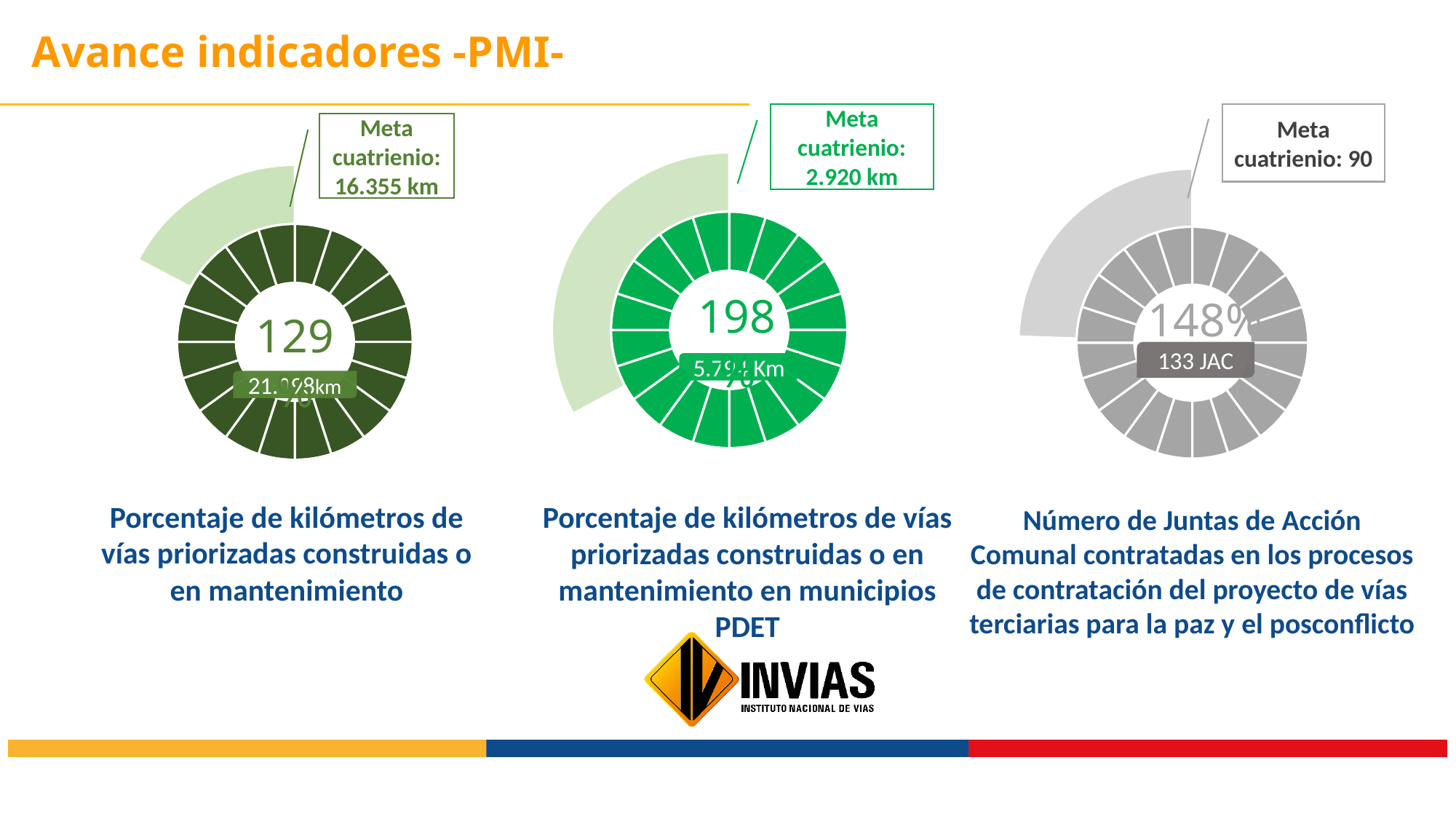
On the right-hand chart, by how much does the reported 133 JAC exceed the Meta cuatrienio of 90? 43 How many ring charts are shown on the slide? 3 On the chart titled 'Número de Juntas de Acción Comunal contratadas...', how many JAC are reported in the label below the percentage? 133 JAC On the chart titled 'Porcentaje de kilómetros de vías priorizadas construidas o en mantenimiento', what value is shown in the centre of the ring? 129 What is the 'Meta cuatrienio' shown for the right-hand chart? 90 What is the 'Meta cuatrienio' shown for the left-hand chart? 16.355 km On the chart titled 'Porcentaje de kilómetros de vías priorizadas construidas o en mantenimiento en municipios PDET', what value is shown in the centre of the ring? 198 Which of the three charts shows the highest central value? Porcentaje de kilómetros de vías priorizadas construidas o en mantenimiento en municipios PDET (198) What is the difference between the central value of the middle chart (198) and the central value of the left-hand chart (129)? 69 What colour is the ring of the middle chart? Green What is the 'Meta cuatrienio' shown for the middle chart? 2.920 km On the chart titled 'Número de Juntas de Acción Comunal contratadas...', what percentage is shown in the centre of the ring? 148%